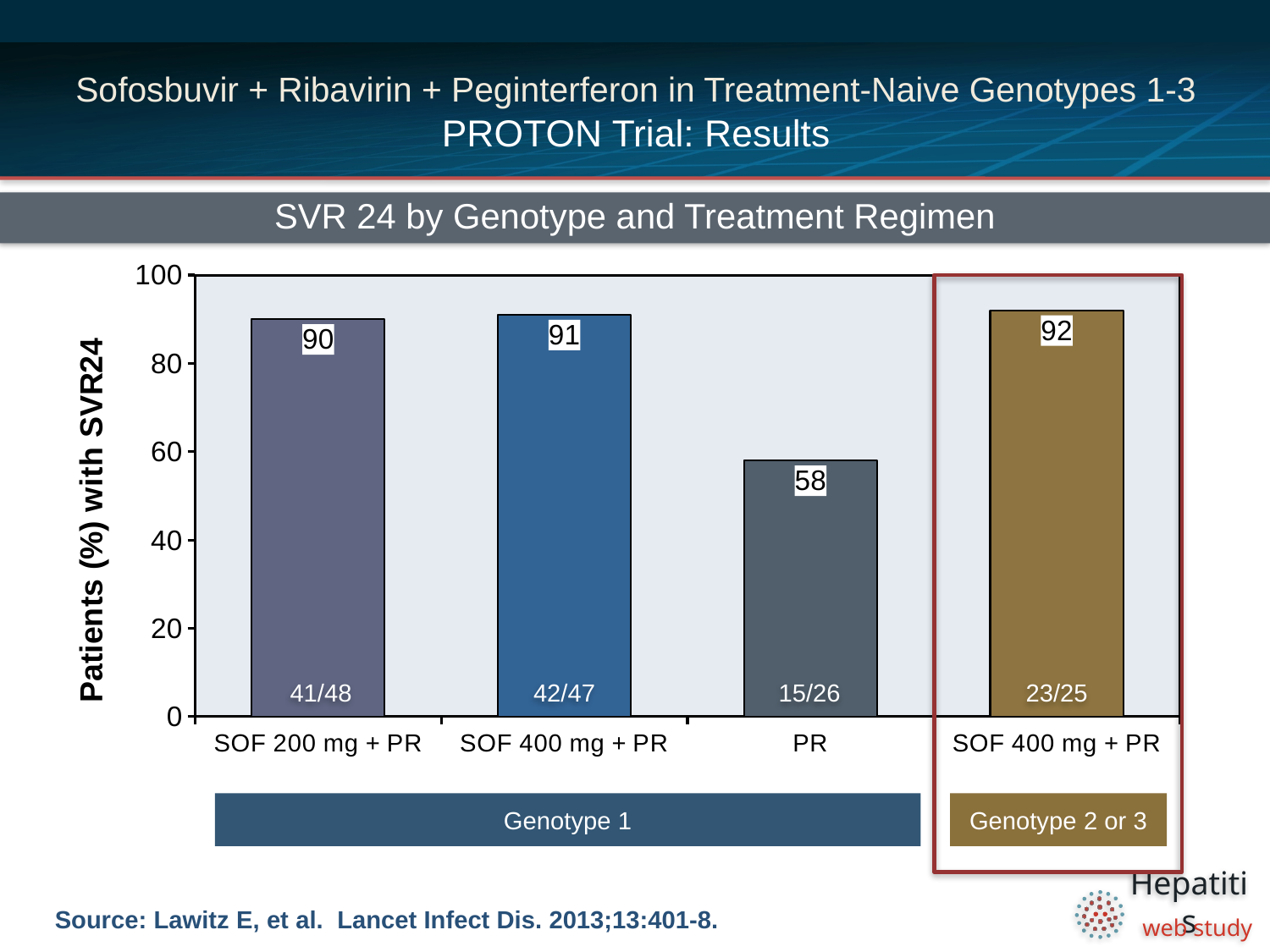
What is the SVR24 rate (%) for SOF 400 mg + PR in Genotype 2 or 3? 92 Which has a higher SVR24 rate: SOF 200 mg + PR in Genotype 1 or PR in Genotype 1? SOF 200 mg + PR What is the SVR24 rate (%) for the PR arm in Genotype 1? 58 Which treatment arm has the highest SVR24 rate? SOF 400 mg + PR (Genotype 2 or 3) What is the label of the y-axis? Patients (%) with SVR24 How many patients achieved SVR24 out of the total in the SOF 400 mg + PR Genotype 1 arm, as printed on the bar? 42/47 What is the difference in SVR24 rate between SOF 400 mg + PR in Genotype 1 and PR in Genotype 1? 33 What is the title of the chart? SVR 24 by Genotype and Treatment Regimen Which treatment arm has the lowest SVR24 rate? PR (Genotype 1) What type of chart is shown on the slide? bar chart What is the SVR24 rate (%) for SOF 200 mg + PR in Genotype 1? 90 How many bars are plotted in the chart? 4